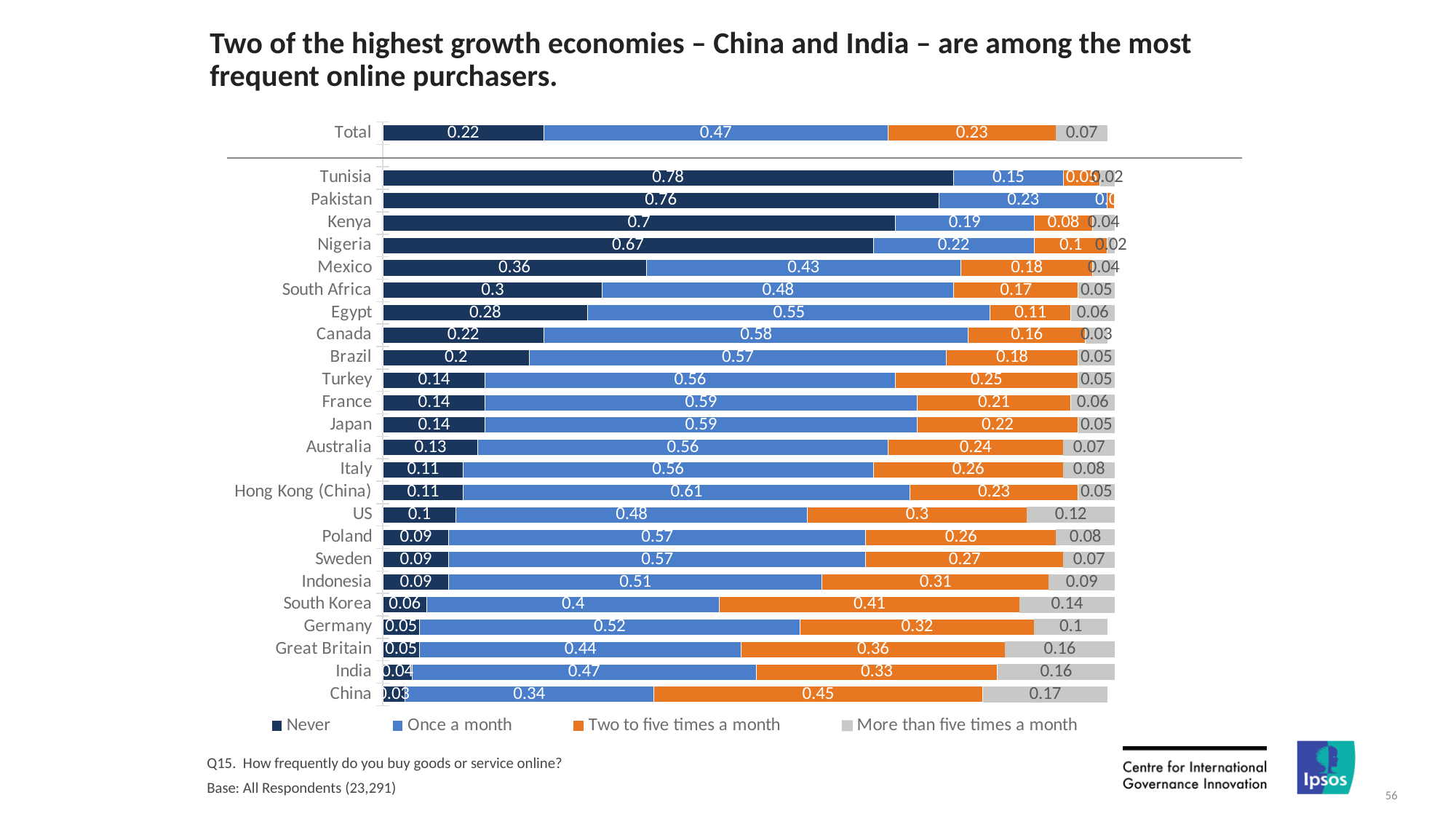
Which country has the lowest 'Never' value? China What is the 'More than five times a month' value for the Total bar? 0.07 What is the 'Two to five times a month' value for China? 0.45 What is the 'Once a month' value for Hong Kong (China)? 0.61 How many series does the legend list? 4 What is the 'Never' value for Tunisia? 0.78 What is the difference between the 'Two to five times a month' values for South Korea and Germany? 0.09 How many countries are shown below the Total bar? 24 Which country has the highest 'Never' value? Tunisia Which country has the highest 'More than five times a month' value? China What kind of chart is shown on the slide? Stacked bar chart Which is larger, the 'Once a month' value for Canada or for Mexico? Canada